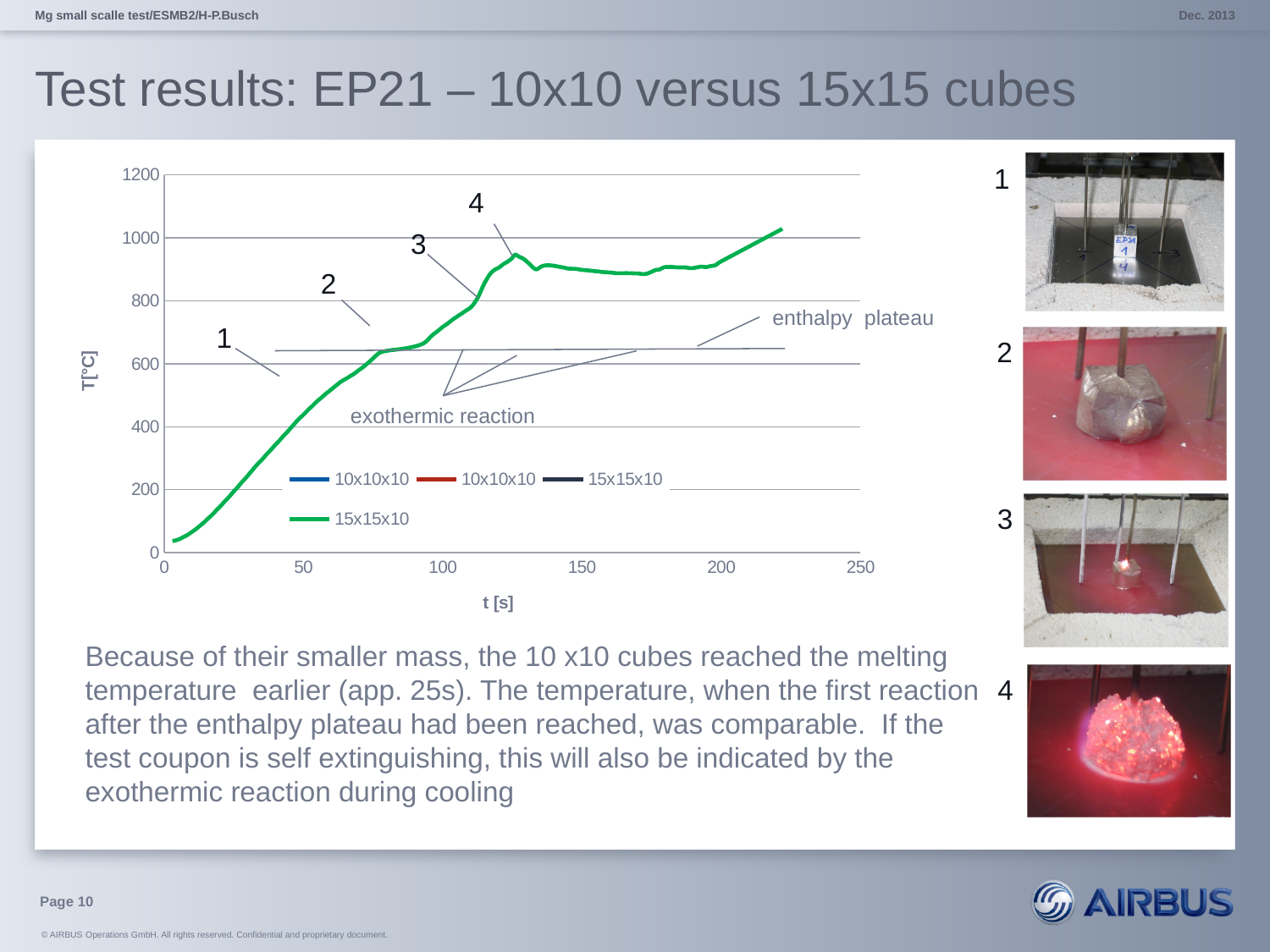
What is the label of the y axis of the chart? T[°C] What is the highest value shown on the x axis of the chart? 250 Is the temperature of the green curve at t = 50 s greater or less than 600? less Which is larger on the green curve: the temperature at t = 50 s or at t = 150 s? t = 150 s Is the temperature of the green curve at t = 100 s greater or less than 800? less What is the label of the x axis of the chart? t [s] Is the temperature of the green curve at t = 200 s greater or less than 1000? less What kind of chart is shown on the slide? line chart How many series does the chart legend list? 4 Does the plotted green temperature curve generally rise or fall as t increases? rise